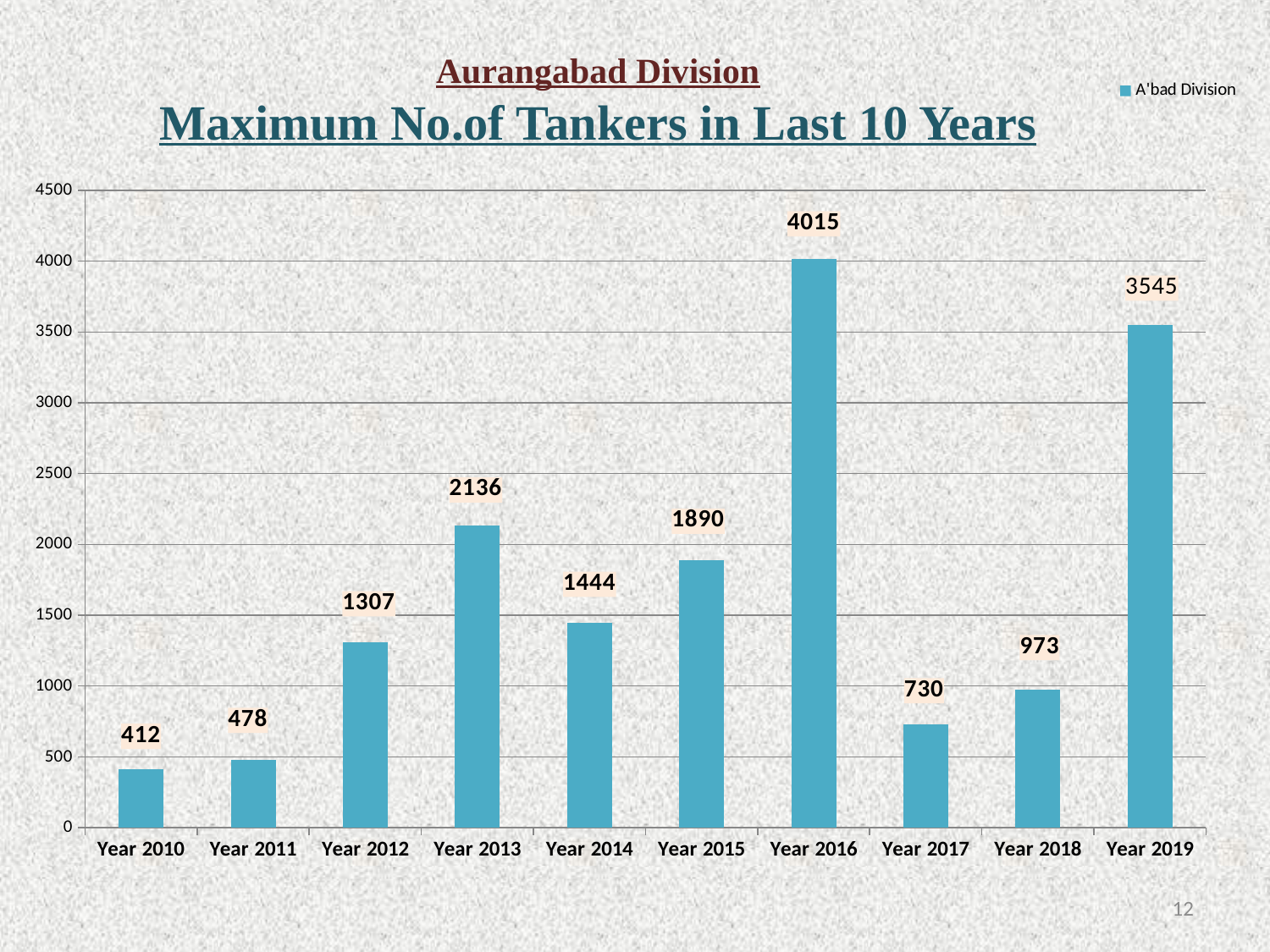
What is the legend entry for the series? A'bad Division How many years are shown on the x axis? 10 How many series does the legend list? 1 Is the value for Year 2014 greater or less than 1500? less What kind of chart is shown on the slide? bar chart Which is larger, the value for Year 2013 or the value for Year 2015? Year 2013 Which year has the highest number of tankers? Year 2016 What is the difference between the values for Year 2019 and Year 2018? 2572 Do the values rise or fall from Year 2016 to Year 2017? fall What is the value shown for Year 2012? 1307 Which year has the lowest number of tankers? Year 2010 What is the maximum number of tankers for Year 2016? 4015